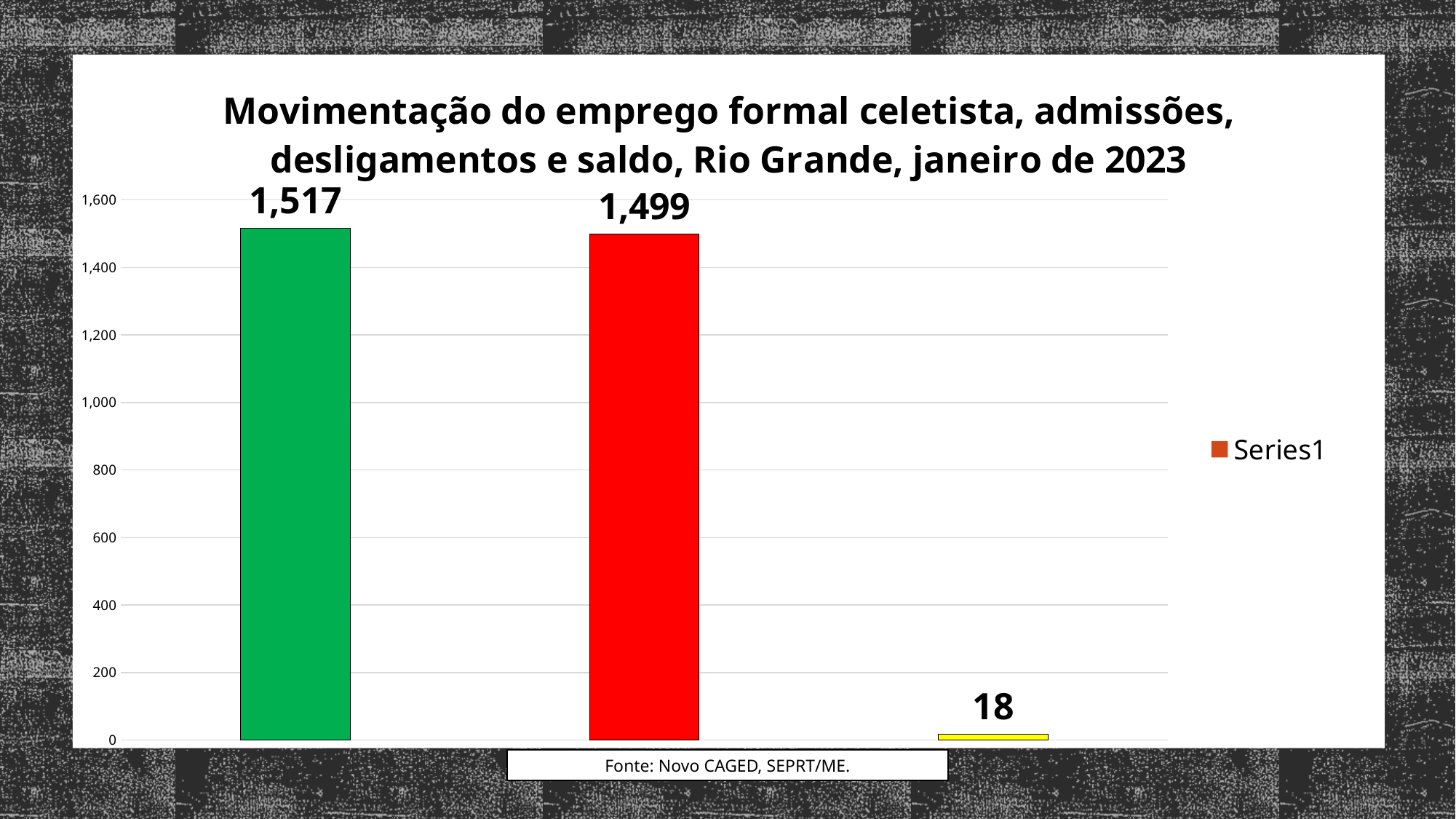
How many bars are plotted in the chart? 3 What is the value shown on the yellow bar? 18 Which is larger, the value of the green bar or the value of the red bar? The green bar Is the value of the yellow bar greater or less than 200? less What is the source cited below the chart? Fonte: Novo CAGED, SEPRT/ME. What is the value shown on the red bar? 1,499 What is the value shown on the green bar? 1,517 What kind of chart is shown on the slide? Bar chart What is the difference between the green bar and the red bar? 18 Which bar has the highest value? The green bar (1,517) Which bar has the lowest value? The yellow bar (18) How many series does the legend list? 1